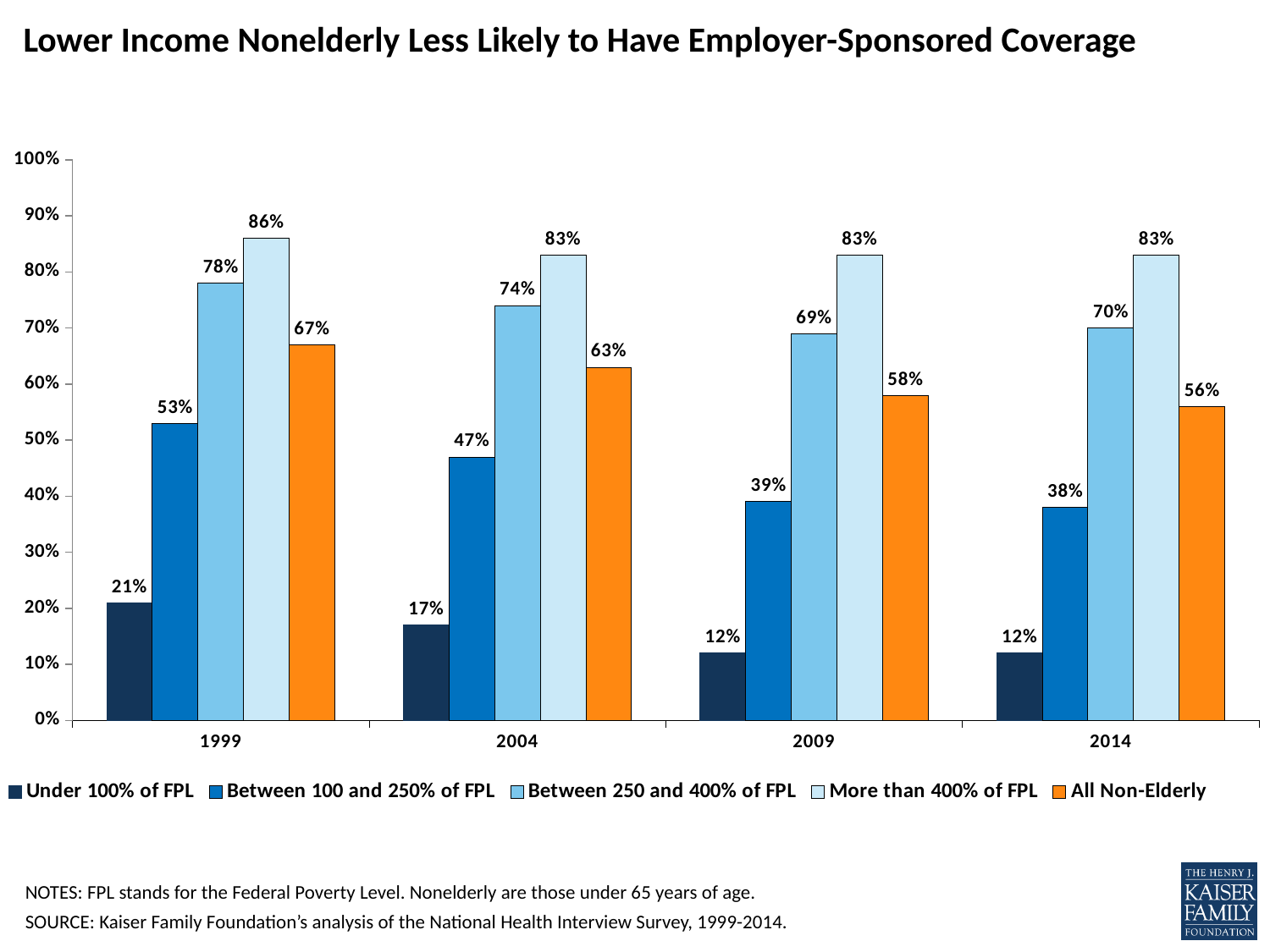
What is the value for Under 100% of FPL in 1999? 21% What is the value for All Non-Elderly in 2014? 56% Which is larger in 2004: Between 250 and 400% of FPL or All Non-Elderly? Between 250 and 400% of FPL What is the difference between the More than 400% of FPL value and the Under 100% of FPL value in 2014? 71% Is the value for Between 100 and 250% of FPL in 2009 greater or less than 40%? less How many series does the legend list? 5 What kind of chart is shown? bar chart Which year has the lowest value for Between 100 and 250% of FPL? 2014 What is the value for Between 250 and 400% of FPL in 2009? 69% How many years are shown on the x axis? 4 Which year has the highest value for More than 400% of FPL? 1999 Does the value for All Non-Elderly rise or fall from 1999 to 2014? fall